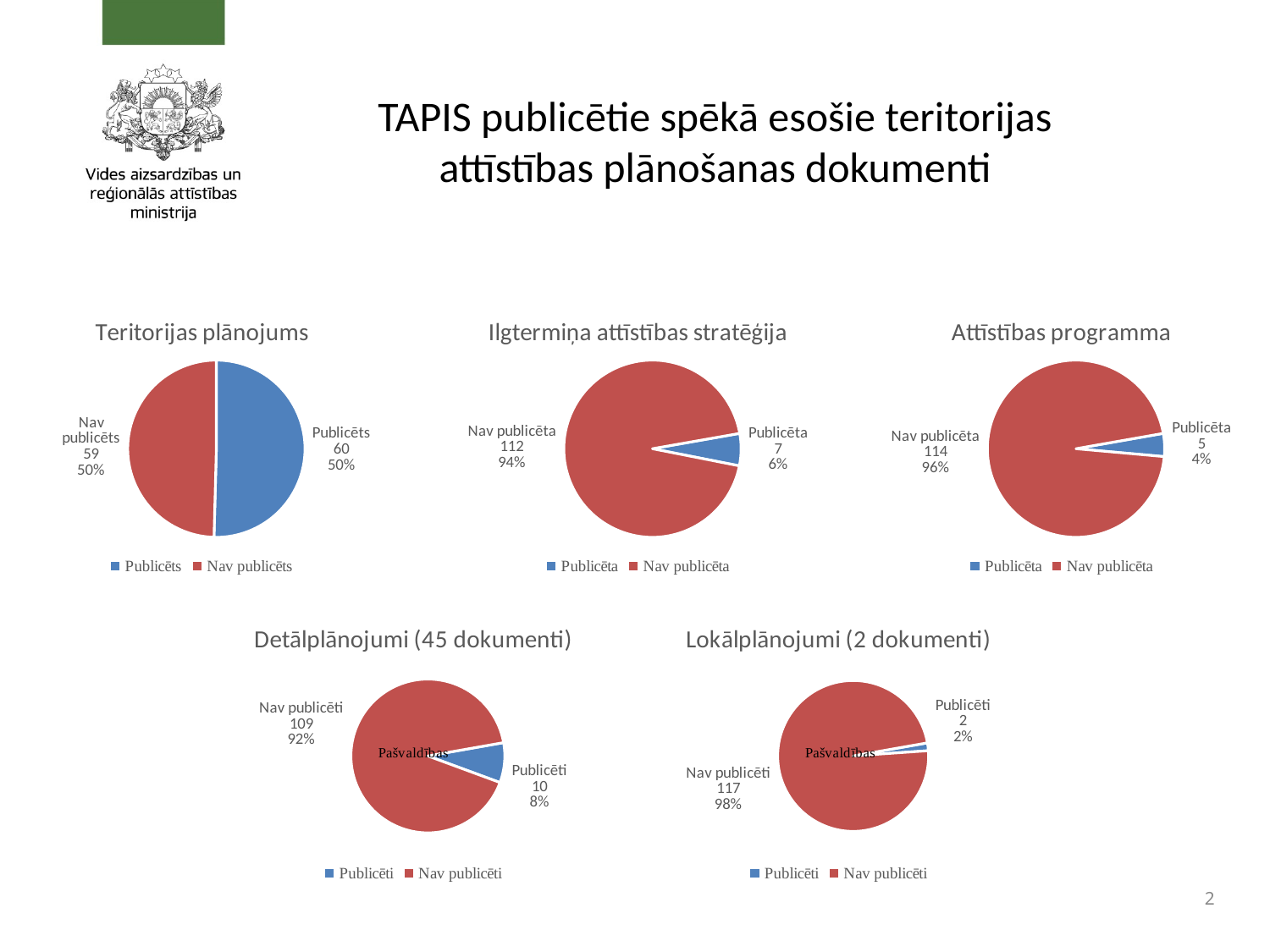
In the "Teritorijas plānojums" chart, what is the value for "Publicēts"? 60 In the "Detālplānojumi (45 dokumenti)" chart, what is the value for "Publicēti"? 10 How many slices does the "Attīstības programma" chart have? 2 In the "Ilgtermiņa attīstības stratēģija" chart, what is the value for "Nav publicēta"? 112 In the "Attīstības programma" chart, which slice is the smallest? Publicēta In the "Teritorijas plānojums" chart, what is the total of "Publicēts" and "Nav publicēts"? 119 In the "Detālplānojumi (45 dokumenti)" chart, what is the difference between "Nav publicēti" and "Publicēti"? 99 In the "Lokālplānojumi (2 dokumenti)" chart, what share of the pie is "Nav publicēti"? 98% In the "Ilgtermiņa attīstības stratēģija" chart, which slice is the largest? Nav publicēta How many charts are shown on the slide? 5 In the "Attīstības programma" chart, what share of the pie is "Publicēta"? 4% What kind of chart is the "Lokālplānojumi (2 dokumenti)" chart? Pie chart